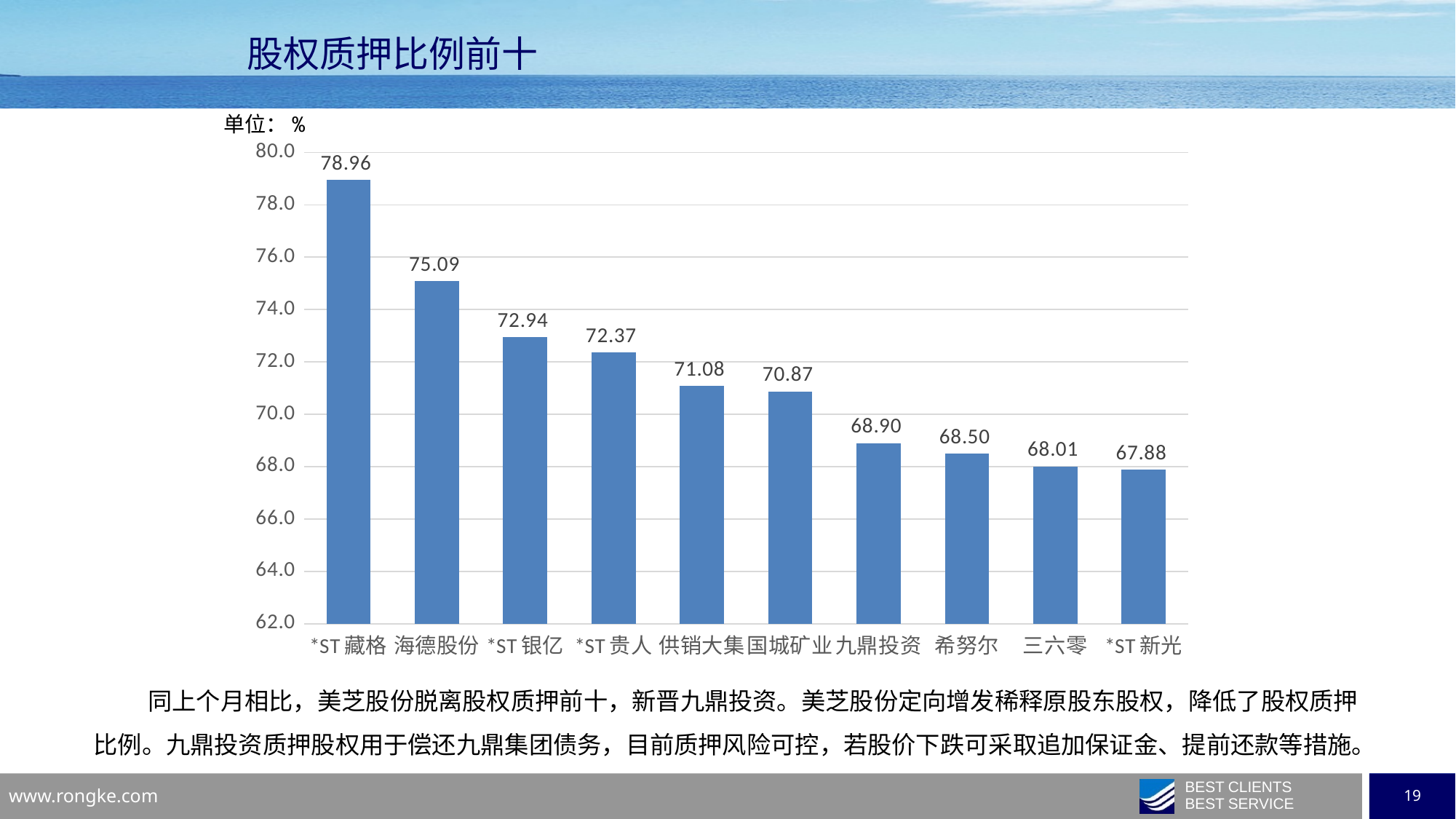
What is the difference between the values for *ST 藏格 and 海德股份? 3.87 Which category has the highest value? *ST 藏格 What is the value for 三六零? 68.01 Which category has the lowest value? *ST 新光 Is the value for *ST 贵人 greater or less than 70.0? greater What is the value for 九鼎投资? 68.90 Which is larger, the value for *ST 银亿 or the value for 希努尔? *ST 银亿 What unit is stated above the chart? % What kind of chart is shown on the slide? Bar chart What is the difference between the values for 供销大集 and 国城矿业? 0.21 How many categories are shown on the x axis? 10 What is the value for 海德股份? 75.09